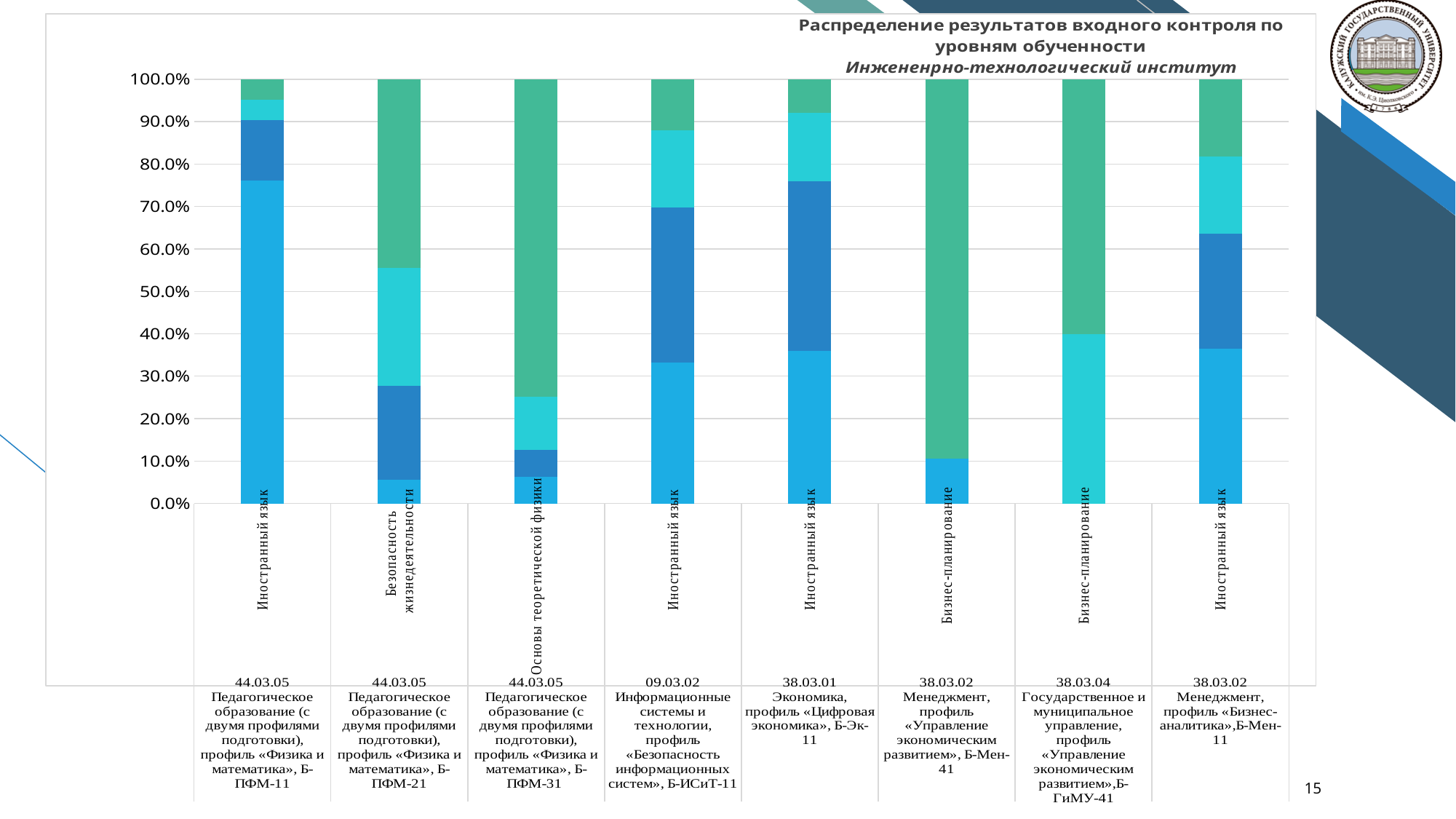
In the bar for 44.03.05 Б-ПФМ-11 (Иностранный язык), does the bottom light-blue segment reach greater or less than 70%? greater Which institute is named in the chart's subtitle? Инжененрно-технологический институт Which bar has the largest light-blue (bottom) segment? 44.03.05 Б-ПФМ-11 (Иностранный язык) Which bar has the largest green (top) segment? 38.03.02 Б-Мен-41 (Бизнес-планирование) What is the title of the chart? Распределение результатов входного контроля по уровням обученности In the bar for 09.03.02 Б-ИСиТ-11 (Иностранный язык), does the bottom light-blue segment reach greater or less than 40%? less What is the total height of each stacked bar, as shown on the vertical axis? 100.0% What type of chart is shown on the slide? stacked bar chart In the bar for 38.03.02 Б-Мен-41 (Бизнес-планирование), does the bottom light-blue segment reach greater or less than 20%? less How many bars (groups/disciplines) are plotted in the chart? 8